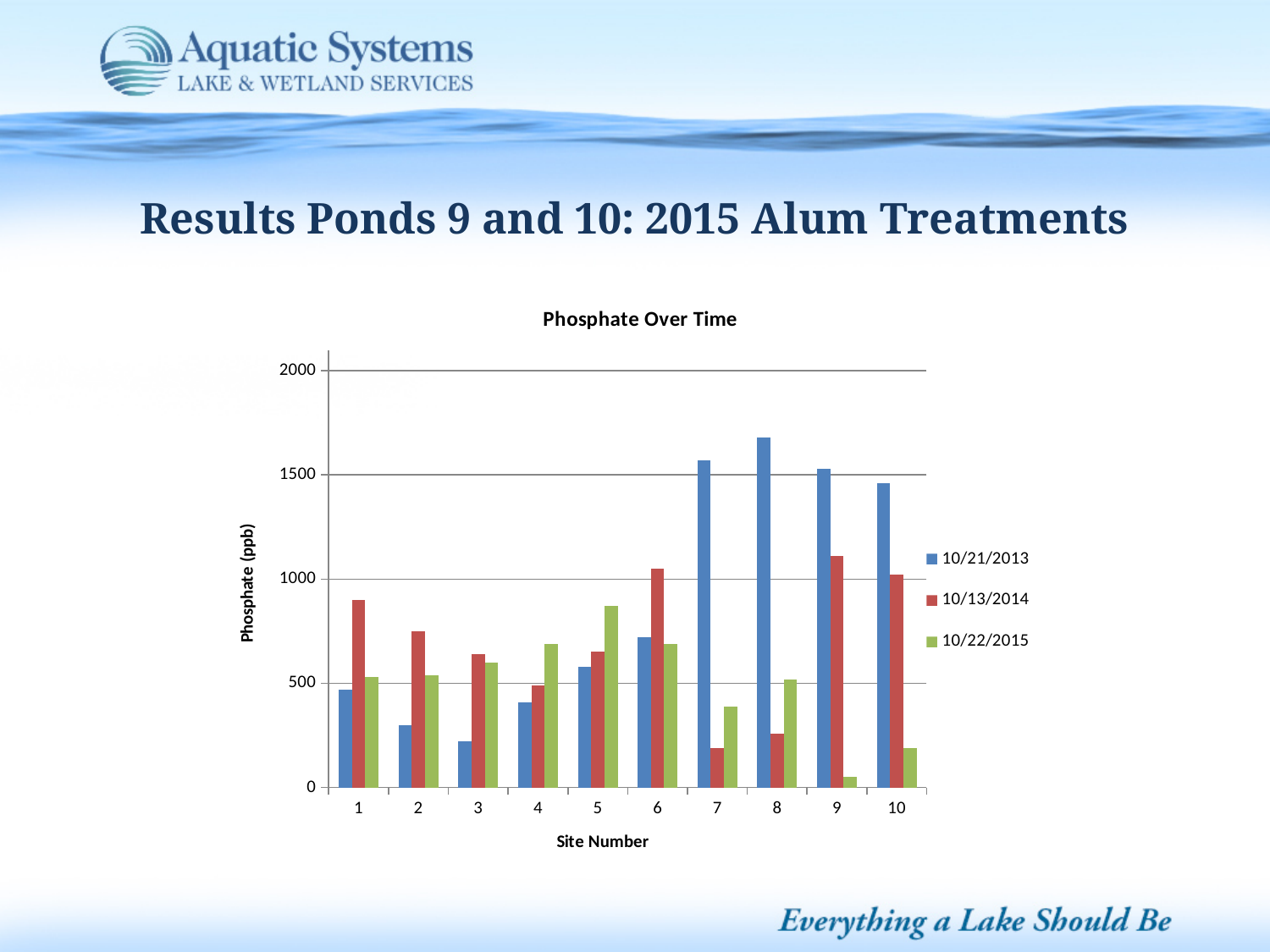
How many site numbers are shown on the x axis? 10 What kind of chart is shown on the slide? bar chart Which site has the lowest phosphate value for 10/22/2015? 9 Which site has the highest phosphate value for 10/21/2013? 8 At site 9, which is larger: the 10/21/2013 value or the 10/22/2015 value? 10/21/2013 What is the title of the chart? Phosphate Over Time Is the 10/13/2014 value for site 1 greater or less than 1000? less What is the label on the y axis? Phosphate (ppb) Is the 10/22/2015 value for site 5 greater or less than 500? greater Is the 10/21/2013 value for site 8 greater or less than 1500? greater At site 1, which is larger: the 10/21/2013 value or the 10/13/2014 value? 10/13/2014 How many series does the legend list? 3